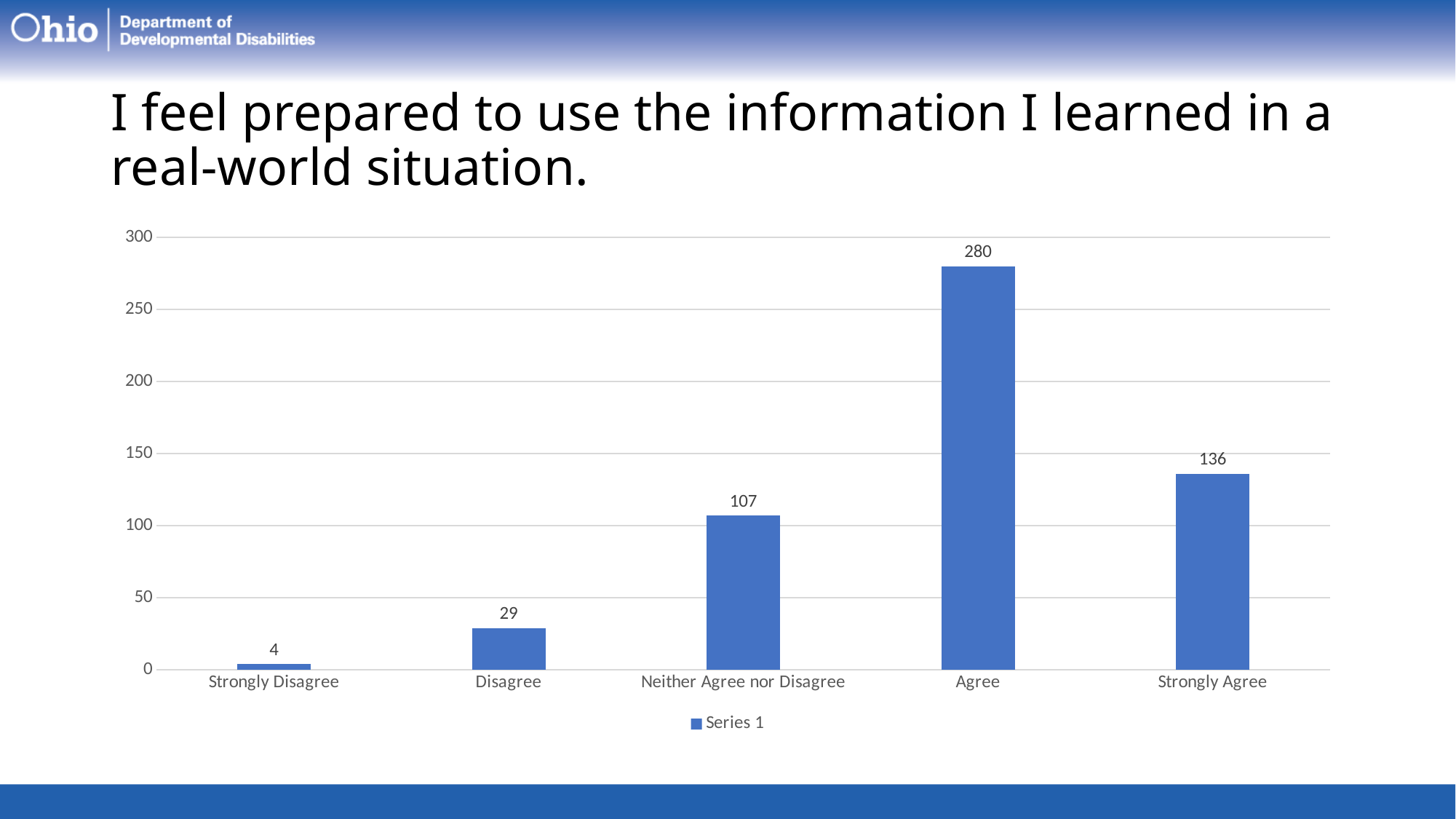
How many series does the legend list? 1 Is the value for Strongly Agree greater or less than 150? less What is the value for Agree? 280 What kind of chart is shown on the slide? bar chart What is the value for Strongly Disagree? 4 What is the difference between the values for Disagree and Strongly Disagree? 25 How many categories are shown on the x axis? 5 What is the value for Neither Agree nor Disagree? 107 What is the difference between the values for Agree and Strongly Agree? 144 Which category has the lowest value? Strongly Disagree Which category has the highest value? Agree Which is larger, the value for Strongly Agree or the value for Neither Agree nor Disagree? Strongly Agree